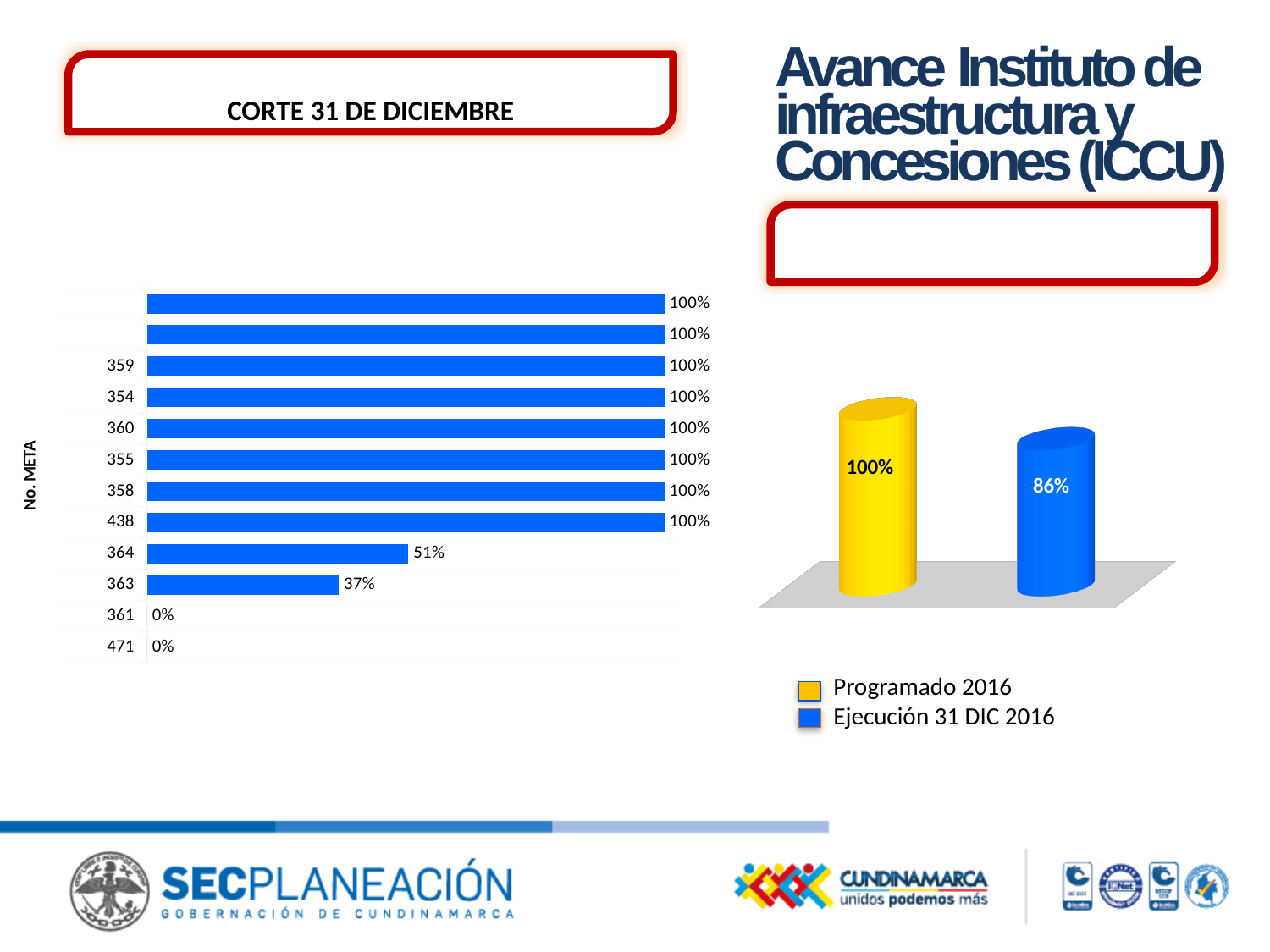
In the right chart, what is the difference between Programado 2016 and Ejecución 31 DIC 2016? 14% In the left bar chart, what is the value for meta 438? 100% In the right chart, what is the value for Ejecución 31 DIC 2016? 86% In the left bar chart, what is the difference between the values for meta 364 and meta 363? 14% In the left bar chart, what is the value for meta 361? 0% In the left bar chart, what is the value for meta 364? 51% In the left bar chart, how many bars (metas) are plotted? 12 What kind of chart is the chart on the left of the slide? Bar chart How many entries does the legend of the right chart list? 2 In the left bar chart, what is the value for meta 363? 37% In the right chart, what is the value for Programado 2016? 100% In the left bar chart, which has the larger value, meta 364 or meta 363? 364